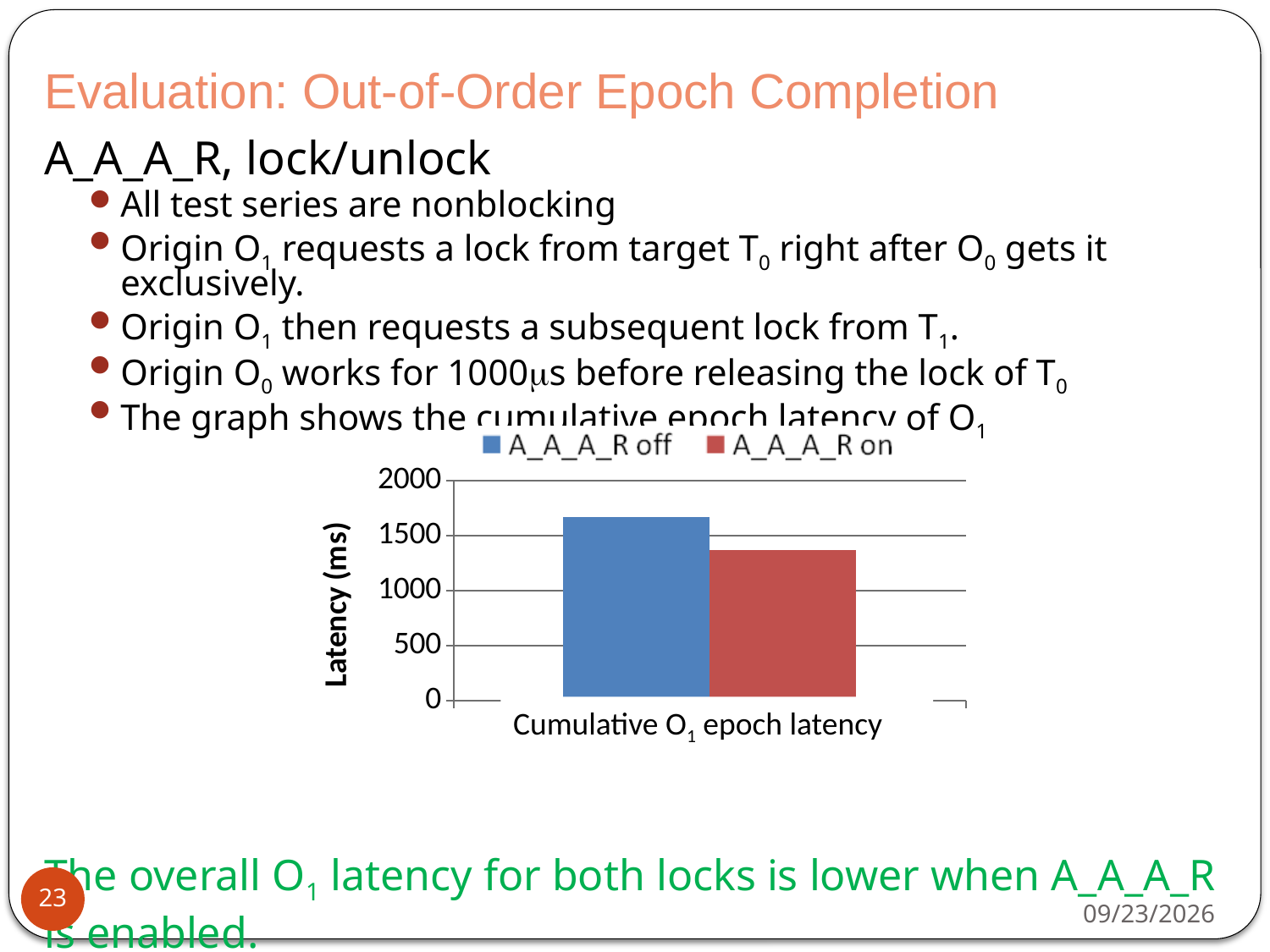
Is the latency for A_A_A_R on greater or less than 1500? less Which series shows the lowest cumulative O1 epoch latency? A_A_A_R on What kind of chart is shown on the slide? bar chart Is the latency for A_A_A_R off greater or less than 2000? less Is the latency for A_A_A_R off greater or less than 1500? greater How many series does the chart legend list? 2 Which series has the higher latency, A_A_A_R off or A_A_A_R on? A_A_A_R off What colour is the bar for the A_A_A_R on series? red What is the label of the y axis of the chart? Latency (ms) How many categories are shown on the x axis of the chart? 1 Which series shows the highest cumulative O1 epoch latency? A_A_A_R off